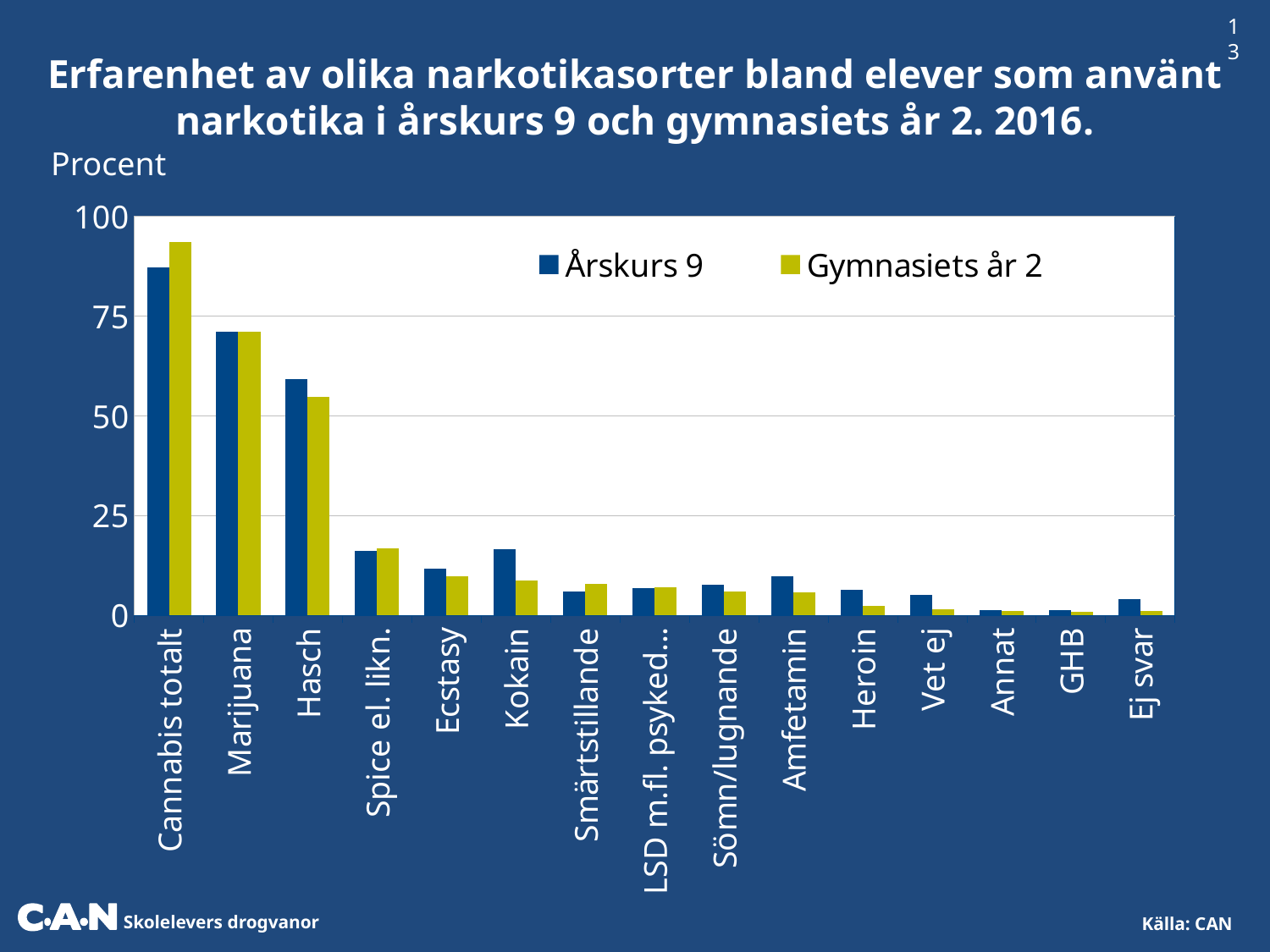
Which category has the highest value for Gymnasiets år 2? Cannabis totalt For Heroin, which series has the larger value, Årskurs 9 or Gymnasiets år 2? Årskurs 9 Is the value for Hasch in the Årskurs 9 series greater or less than 50? greater Is the value for Cannabis totalt in the Gymnasiets år 2 series greater or less than 75? greater Is the value for Spice el. likn. in the Årskurs 9 series greater or less than 25? less For Cannabis totalt, which series has the larger value, Årskurs 9 or Gymnasiets år 2? Gymnasiets år 2 For Kokain, which series has the larger value, Årskurs 9 or Gymnasiets år 2? Årskurs 9 What kind of chart is shown on the slide? Bar chart How many categories are shown along the x axis? 15 How many series does the legend list? 2 What are the two series named in the legend? Årskurs 9 and Gymnasiets år 2 Which category has the highest value for Årskurs 9? Cannabis totalt